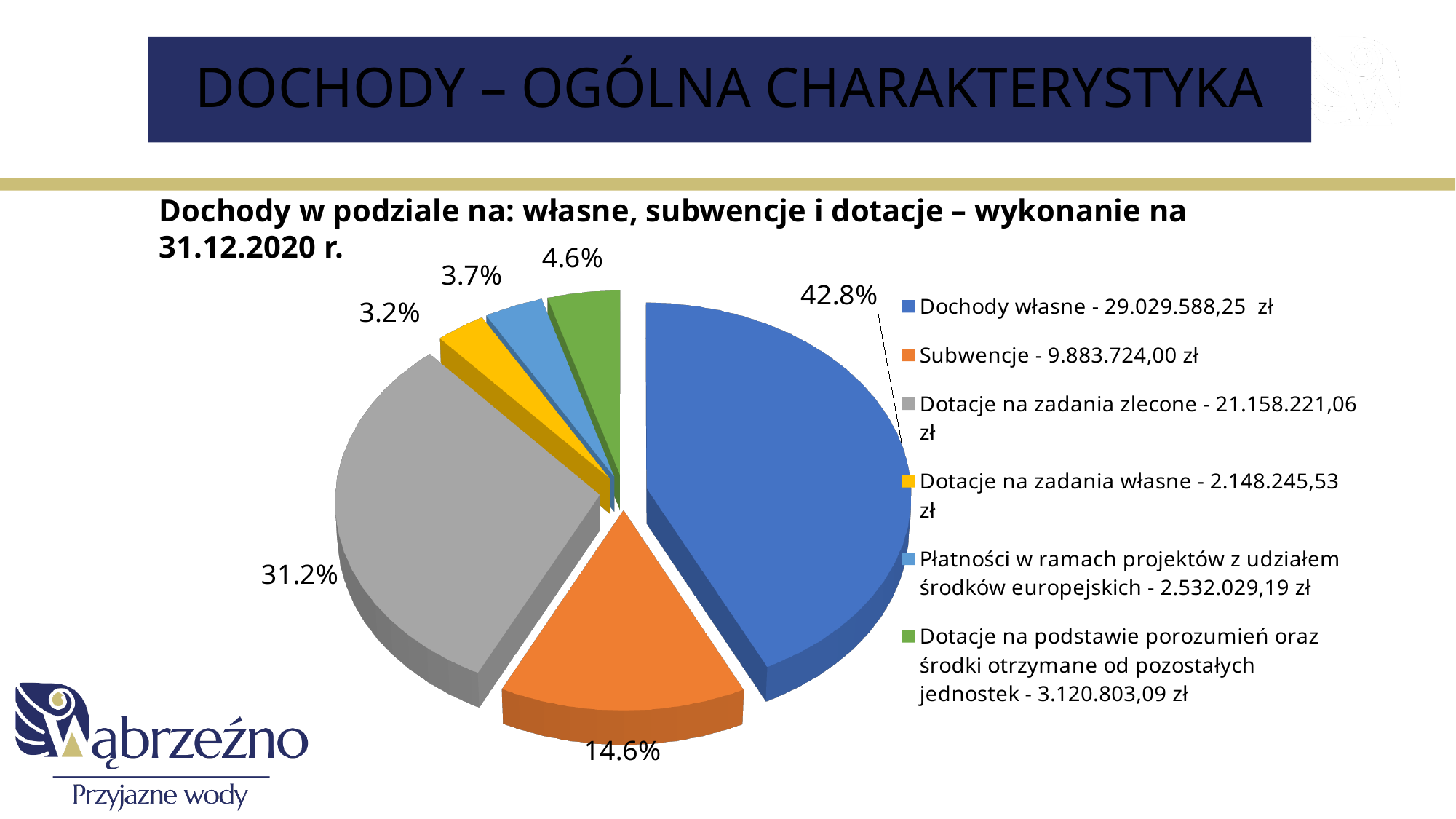
Which category has the largest share of the pie? Dochody własne Which category has the smallest share of the pie? Dotacje na zadania własne What amount does the legend give for "Subwencje"? 9.883.724,00 zł What is the difference in percentage points between the shares of "Dochody własne" and "Dotacje na zadania zlecone"? 11.6 What share of the pie does "Płatności w ramach projektów z udziałem środków europejskich" represent? 3.7% What share of the pie does "Dotacje na zadania zlecone" represent? 31.2% How many slices does the pie chart have? 6 What kind of chart is shown on the slide? pie chart What share of the pie does "Dotacje na zadania własne" represent? 3.2% Which has a larger share: "Subwencje" or "Dotacje na podstawie porozumień oraz środki otrzymane od pozostałych jednostek"? Subwencje